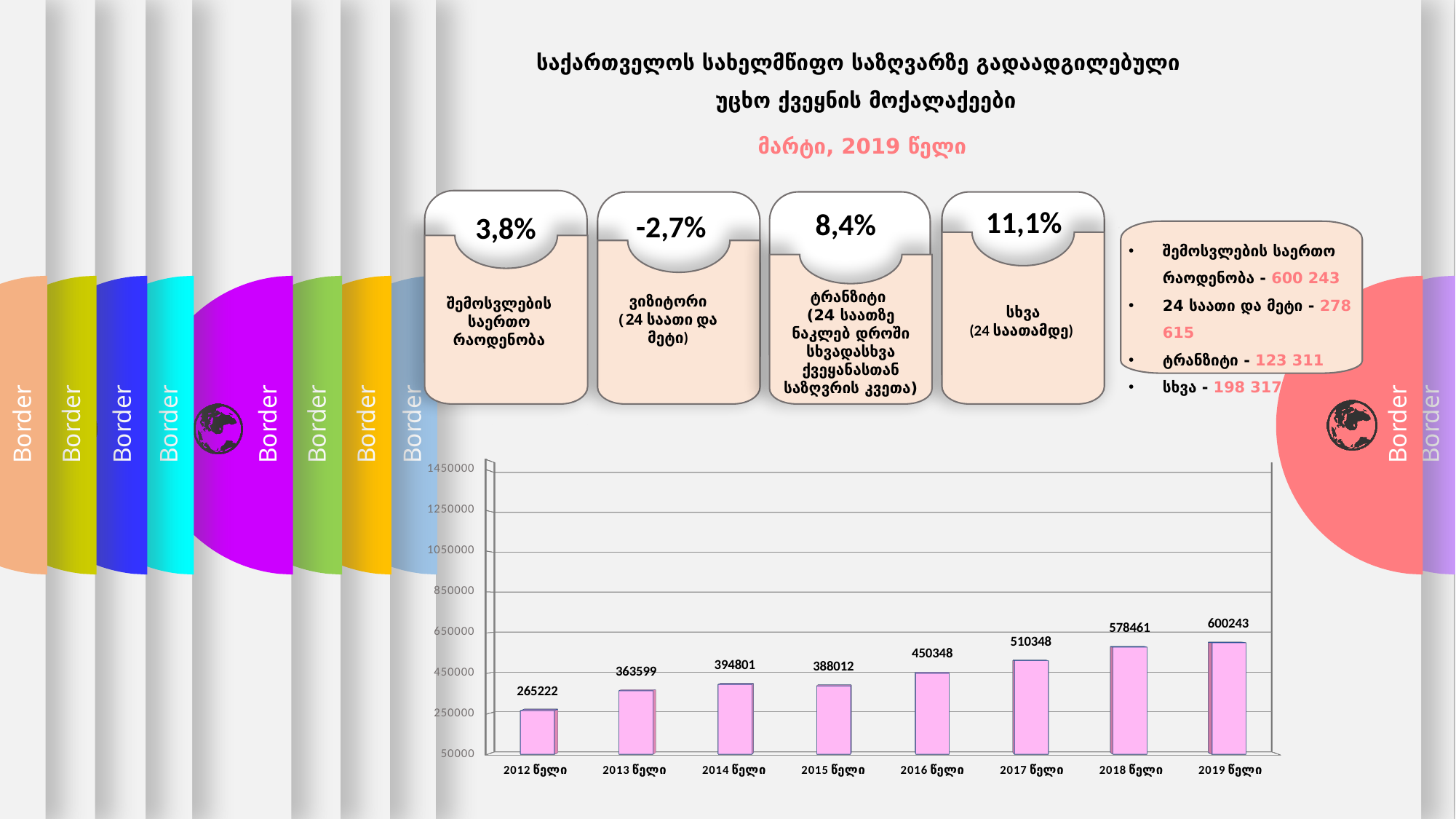
Which year has the highest value? 2019 წელი What is the difference between the values for 2013 წელი and 2012 წელი? 98377 Is the value for 2017 წელი greater or less than 450000? greater What is the difference between the values for 2019 წელი and 2018 წელი? 21782 How many years are shown on the x axis? 8 What is the value for 2019 წელი? 600243 What kind of chart is shown on the slide? bar chart Do the values generally rise or fall from 2012 წელი to 2019 წელი? rise What is the value for 2016 წელი? 450348 Which is larger, the value for 2014 წელი or 2015 წელი? 2014 წელი What is the value for 2012 წელი? 265222 Which year has the lowest value? 2012 წელი